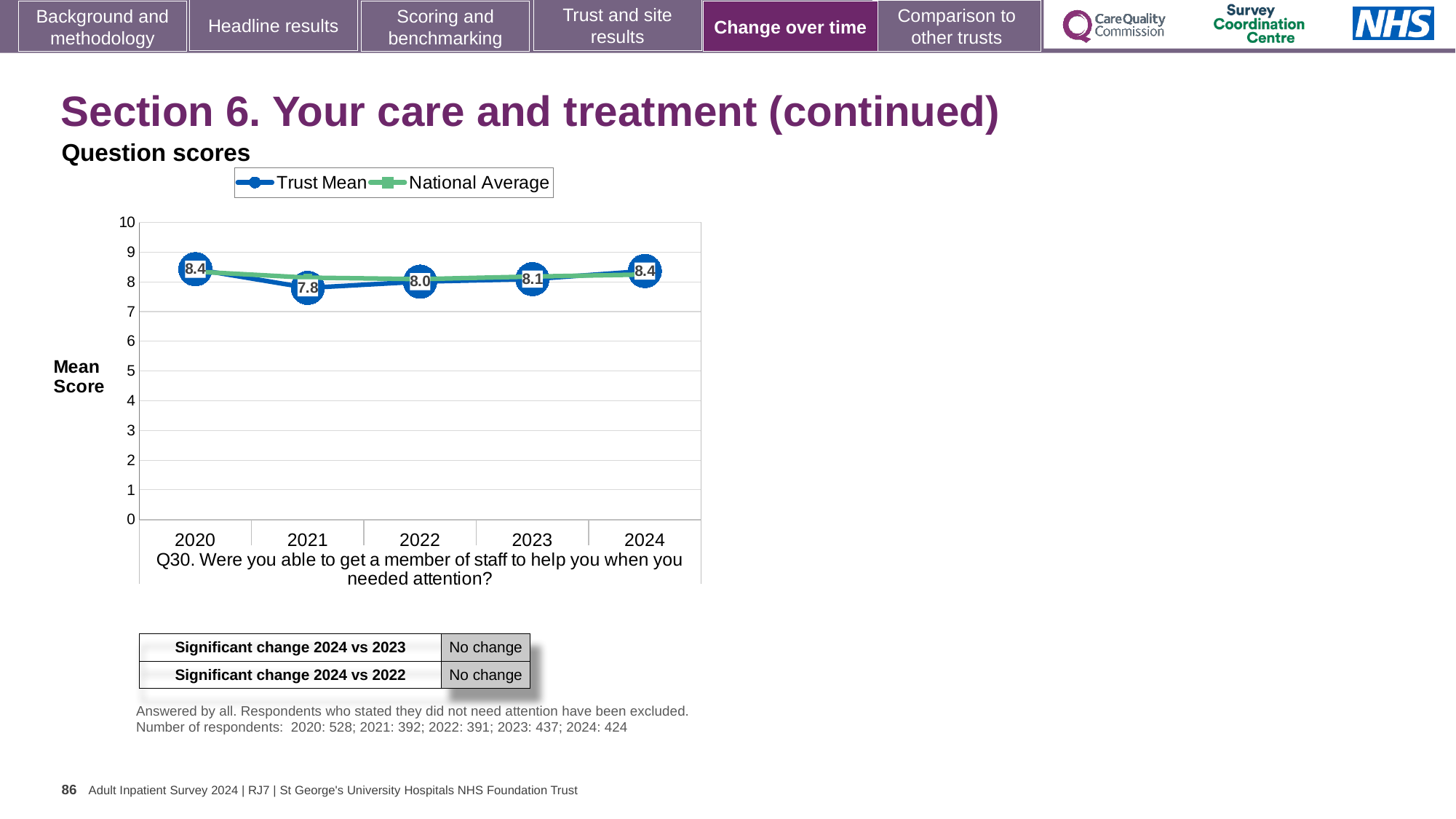
What kind of chart is used to show the Q30 question scores? Line chart What is the Trust Mean score for 2022 in the Q30 chart? 8.0 What is the difference between the Trust Mean scores for 2024 and 2021 in the Q30 chart? 0.6 What is the label on the y axis of the Q30 chart? Mean Score In which year is the Trust Mean score lowest in the Q30 chart? 2021 Does the Trust Mean score rise or fall from 2021 to 2024 in the Q30 chart? Rise Which year has the larger Trust Mean score in the Q30 chart, 2021 or 2023? 2023 What is the Trust Mean score for 2024 in the Q30 chart? 8.4 Is the National Average value for 2021 in the Q30 chart greater or less than 7? greater How many series does the legend of the Q30 chart list? 2 What is the Trust Mean score for 2021 in the Q30 chart? 7.8 How many years are plotted on the x axis of the Q30 chart? 5